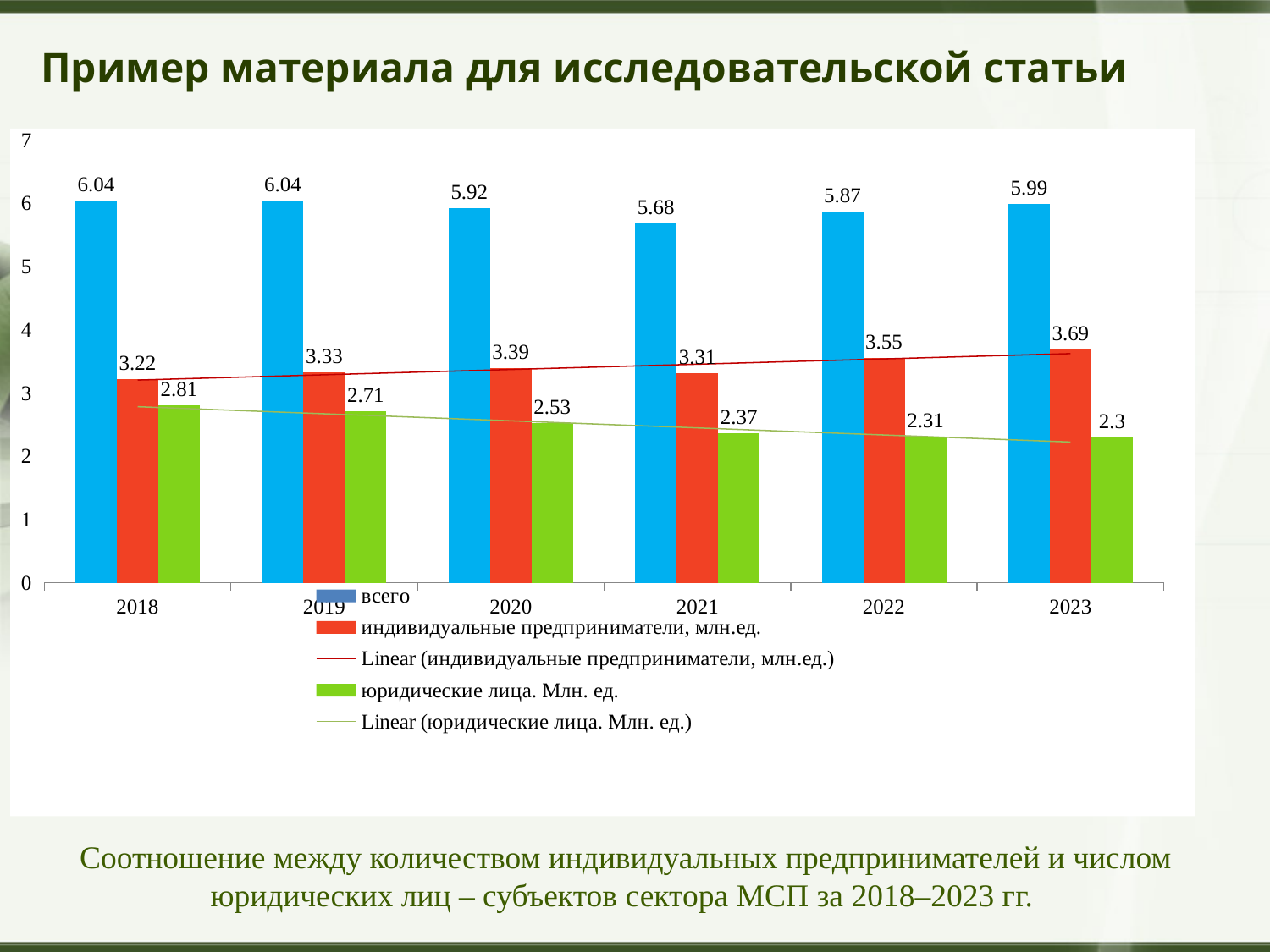
What kind of chart is shown on the slide? bar chart What is the difference between the 'индивидуальные предприниматели' value and the 'юридические лица' value in 2018? 0.41 In which year is the 'индивидуальные предприниматели, млн.ед.' value the highest? 2023 In which year is the 'всего' value the lowest? 2021 In which year is the 'юридические лица. Млн. ед.' value the lowest? 2023 Which is larger in 2022: the 'индивидуальные предприниматели' value or the 'юридические лица' value? индивидуальные предприниматели What is the value for 'юридические лица. Млн. ед.' in 2020? 2.53 What is the value for 'индивидуальные предприниматели, млн.ед.' in 2023? 3.69 Do the 'юридические лица. Млн. ед.' values rise or fall from 2018 to 2023? fall How many entries does the legend list? 5 What is the value of the 'всего' series for 2021? 5.68 How many years are shown on the x axis? 6